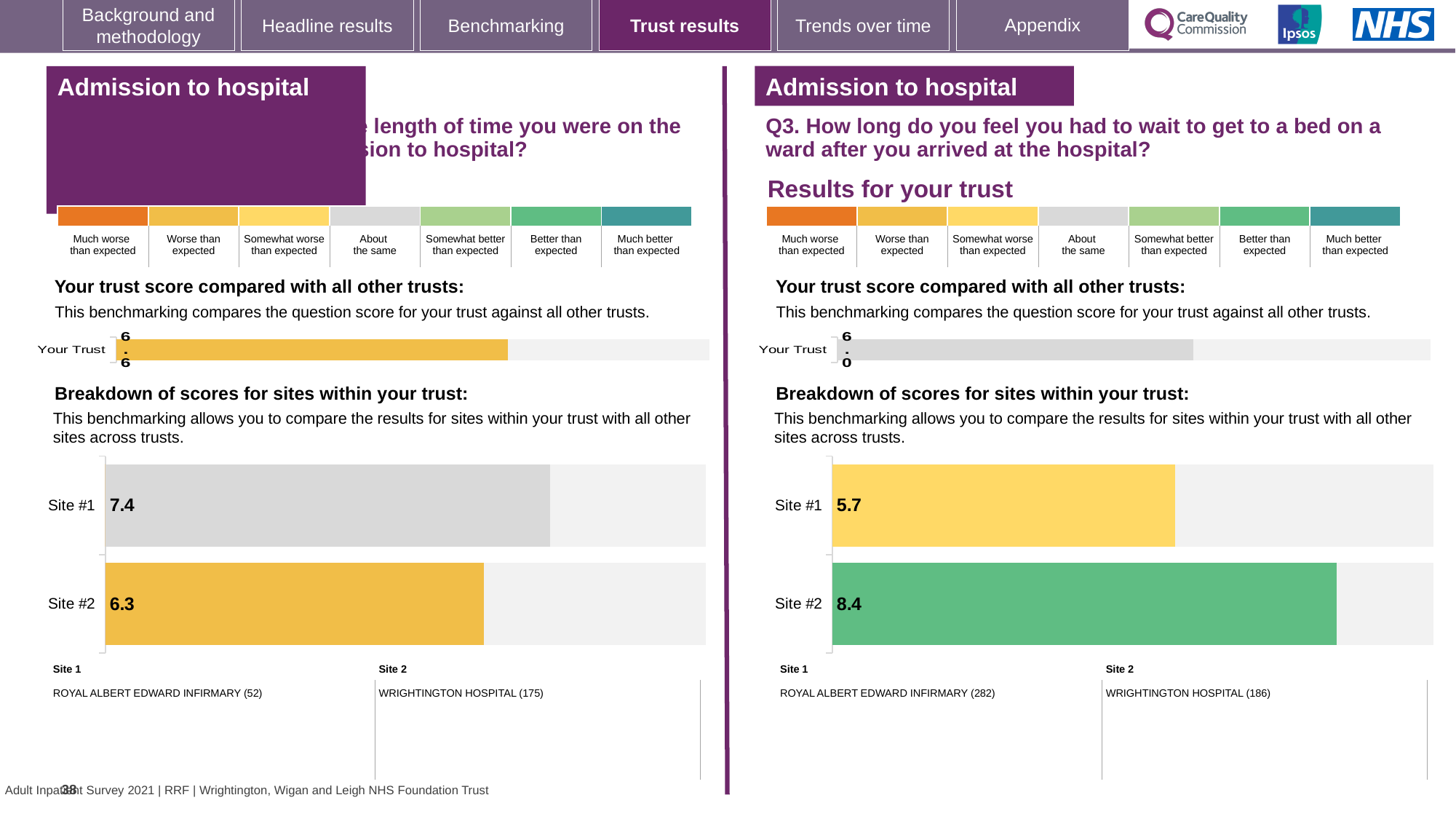
On the left-hand site breakdown chart, which site has the lower score? Site #2 On the right-hand chart (Q3), which site has the higher score? Site #2 On the right-hand chart (Q3), what is the difference between the Site #2 and Site #1 scores? 2.7 On the left-hand site breakdown chart, what is the score for Site #2? 6.3 On the right-hand chart (Q3, wait to get to a bed on a ward), what is the score for Site #1? 5.7 On the right-hand chart (Q3), what is the score for Site #2? 8.4 How many sites are shown in the right-hand (Q3) site breakdown chart? 2 On the left-hand site breakdown chart, what is the score for Site #1? 7.4 What type of chart is used for the site breakdown on the right-hand side (Q3)? bar chart On the left-hand site breakdown chart, what is the difference between the Site #1 and Site #2 scores? 1.1 On the left-hand site breakdown chart, is the score for Site #1 larger or smaller than the score for Site #2? larger On the right-hand chart (Q3), what colour is the bar for Site #2? green